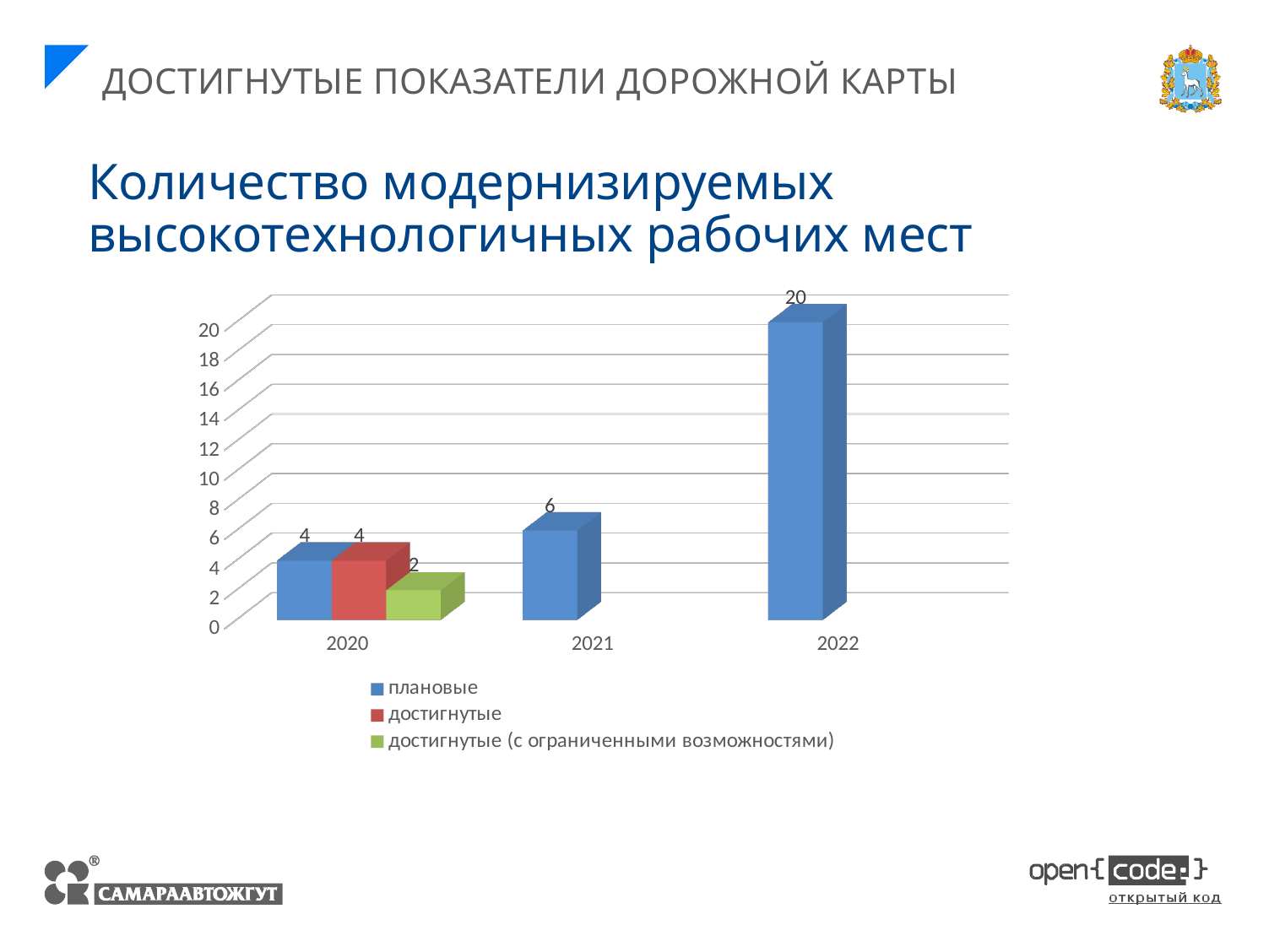
What is the planned (плановые) value for 2021? 6 What is the achieved (достигнутые) value for 2020? 4 What is the difference between the planned value for 2022 and the planned value for 2021? 14 Do the planned (плановые) values rise or fall from 2020 to 2022? rise How many years are shown on the x axis? 3 What is the planned (плановые) value for 2022? 20 Which is larger: the planned value for 2021 or the planned value for 2020? 2021 What is the value for 'достигнутые (с ограниченными возможностями)' in 2020? 2 What type of chart is shown on the slide? bar chart How many series does the legend list? 3 Which year has the lowest planned (плановые) value? 2020 Which year has the highest planned (плановые) value? 2022